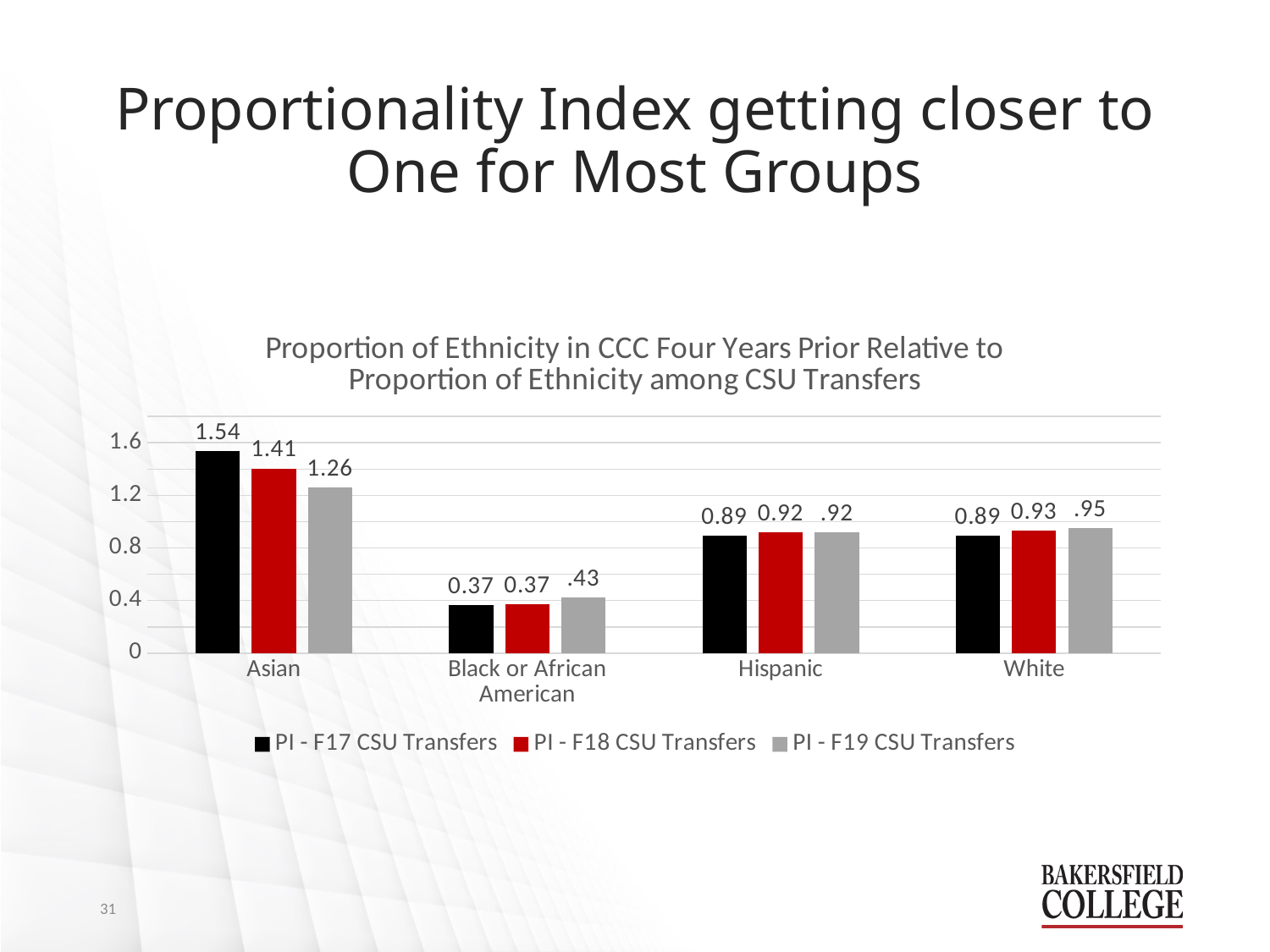
Do the values for Asian rise or fall from PI - F17 to PI - F19 CSU Transfers? Fall How many series does the legend list? 3 What is the difference between the PI - F17 and PI - F19 CSU Transfers values for Asian? 0.28 What kind of chart is shown on the slide? Bar chart Is the PI - F18 CSU Transfers value for Asian greater or less than 1.2? greater Which ethnicity group has the lowest PI - F19 CSU Transfers value? Black or African American Which ethnicity group has the highest PI - F17 CSU Transfers value? Asian Which is larger for Hispanic: the PI - F17 CSU Transfers value or the PI - F18 CSU Transfers value? PI - F18 CSU Transfers What is the PI - F17 CSU Transfers value for Asian? 1.54 What is the PI - F19 CSU Transfers value for Black or African American? .43 How many ethnicity groups are shown on the x axis? 4 What is the PI - F18 CSU Transfers value for White? 0.93